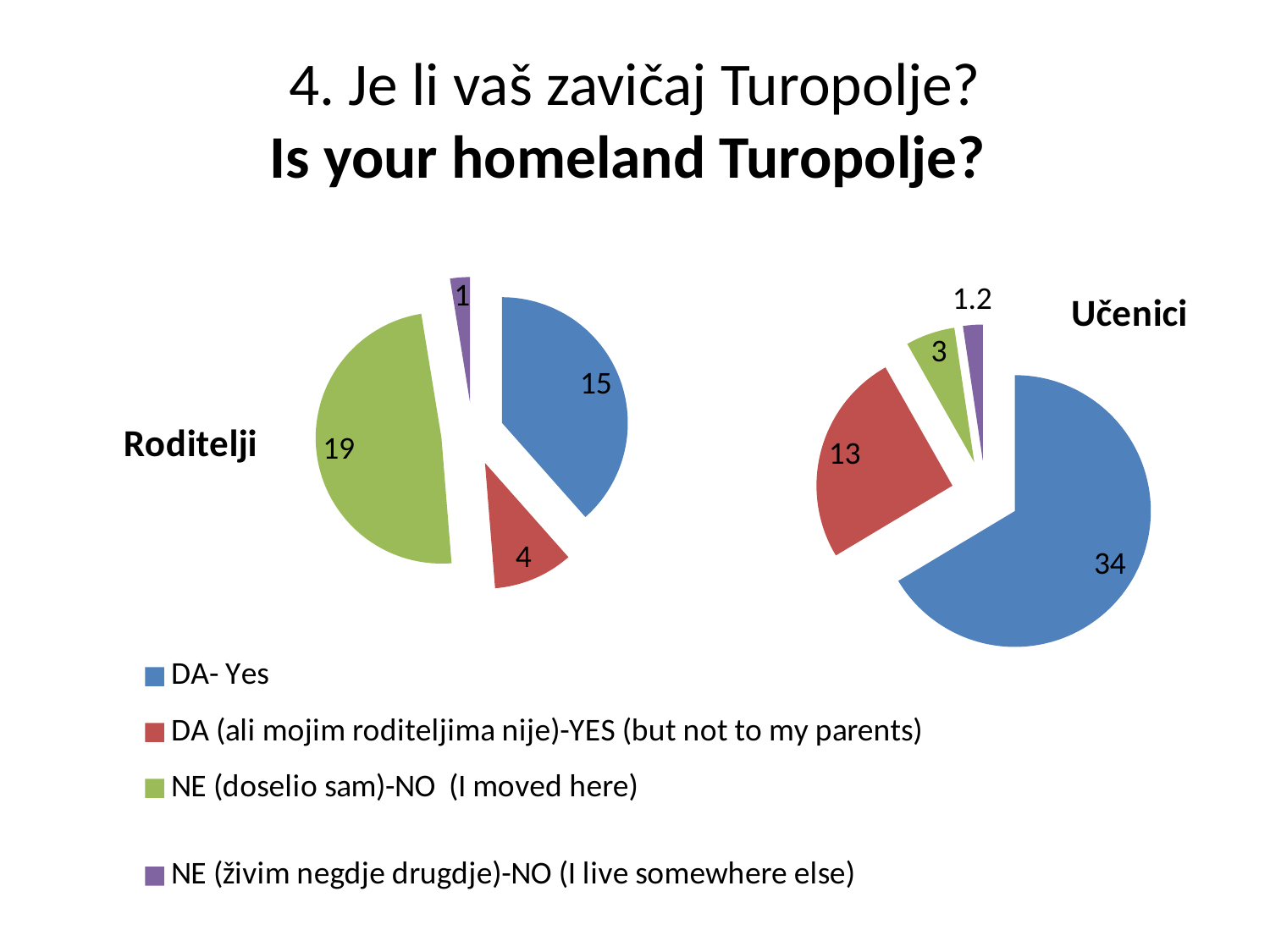
In the Učenici pie chart, what is the value for DA- Yes? 34 In the Učenici pie chart, what is the value for DA (ali mojim roditeljima nije)-YES (but not to my parents)? 13 Which is larger: the DA- Yes value in the Roditelji chart or the DA- Yes value in the Učenici chart? Učenici In the Učenici pie chart, what is the difference between the DA- Yes value and the DA (ali mojim roditeljima nije) value? 21 In the Učenici pie chart, what is the value for NE (živim negdje drugdje)-NO (I live somewhere else)? 1.2 In the Roditelji pie chart, what is the difference between the NE (doselio sam) value and the DA- Yes value? 4 In the Roditelji pie chart, what is the value for NE (doselio sam)-NO (I moved here)? 19 In the Roditelji pie chart, what is the value for DA- Yes? 15 In the Učenici pie chart, which category has the smallest slice? NE (živim negdje drugdje)-NO (I live somewhere else) How many slices does the Roditelji pie chart have? 4 In the Roditelji pie chart, which category has the largest slice? NE (doselio sam)-NO (I moved here) What type of chart is used for the Učenici data? Pie chart